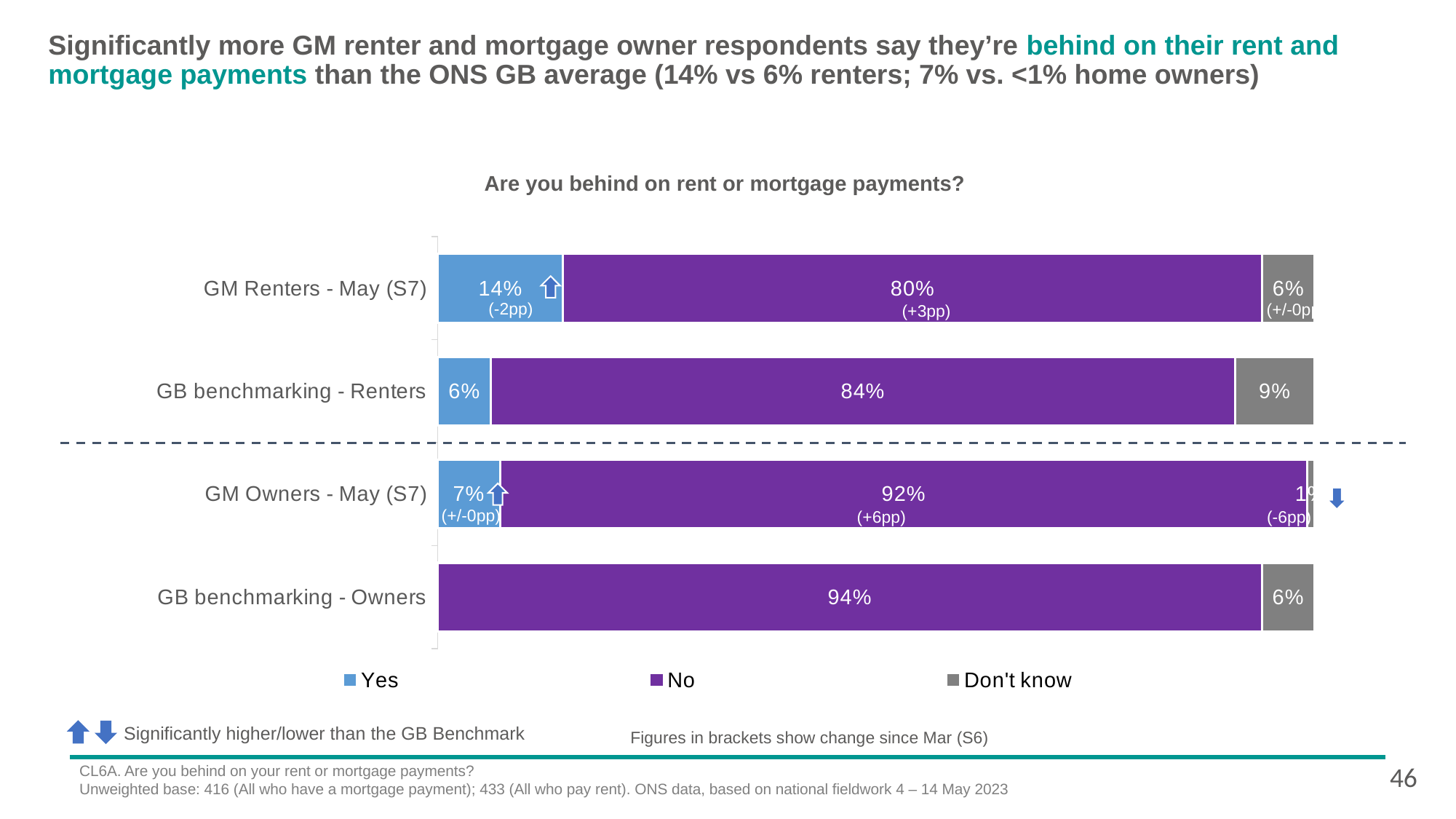
Which is larger: the Don't know percentage for GB benchmarking - Renters or for GM Renters - May (S7)? GB benchmarking - Renters What kind of chart is shown on the slide? Stacked bar chart How many categories are shown on the chart? 4 What is the difference in the Yes percentage between GM Renters - May (S7) and GB benchmarking - Renters? 8 percentage points What percentage of GB benchmarking - Renters answered No? 84% What is the title of the chart? Are you behind on rent or mortgage payments? How many series does the legend list? 3 Which category has the highest Yes percentage? GM Renters - May (S7) Which category has the highest No percentage? GB benchmarking - Owners What percentage of GM Owners - May (S7) answered No? 92% What percentage of GB benchmarking - Owners answered Don't know? 6% What percentage of GM Renters - May (S7) answered Yes? 14%